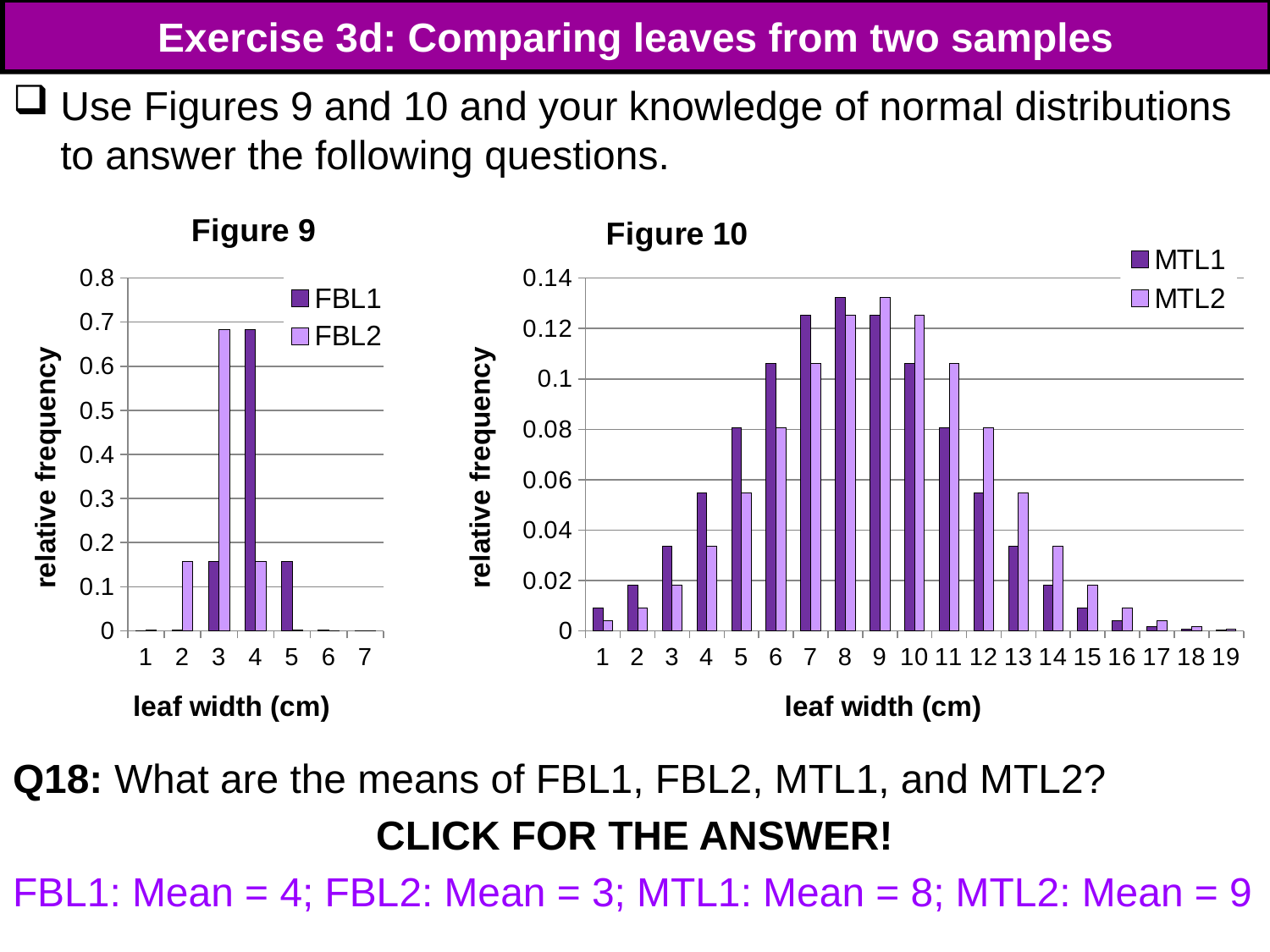
In Figure 9, at which leaf width (cm) does FBL2 have its highest relative frequency? 3 In Figure 10, at which leaf width (cm) does MTL1 reach its highest relative frequency? 8 In Figure 10, at which leaf width (cm) does MTL2 reach its highest relative frequency? 9 In Figure 9, which series has the larger relative frequency at leaf width 5 cm, FBL1 or FBL2? FBL1 How many leaf width categories are shown on the x axis of Figure 9? 7 What are the two series listed in the legend of Figure 10? MTL1 and MTL2 How many series does the legend of Figure 9 list? 2 What kind of chart is Figure 9? bar chart How many leaf width categories are shown on the x axis of Figure 10? 19 In Figure 9, is the relative frequency of FBL1 at leaf width 4 cm greater or less than 0.6? greater In Figure 10, is the relative frequency of MTL1 at leaf width 4 cm greater or less than 0.06? less